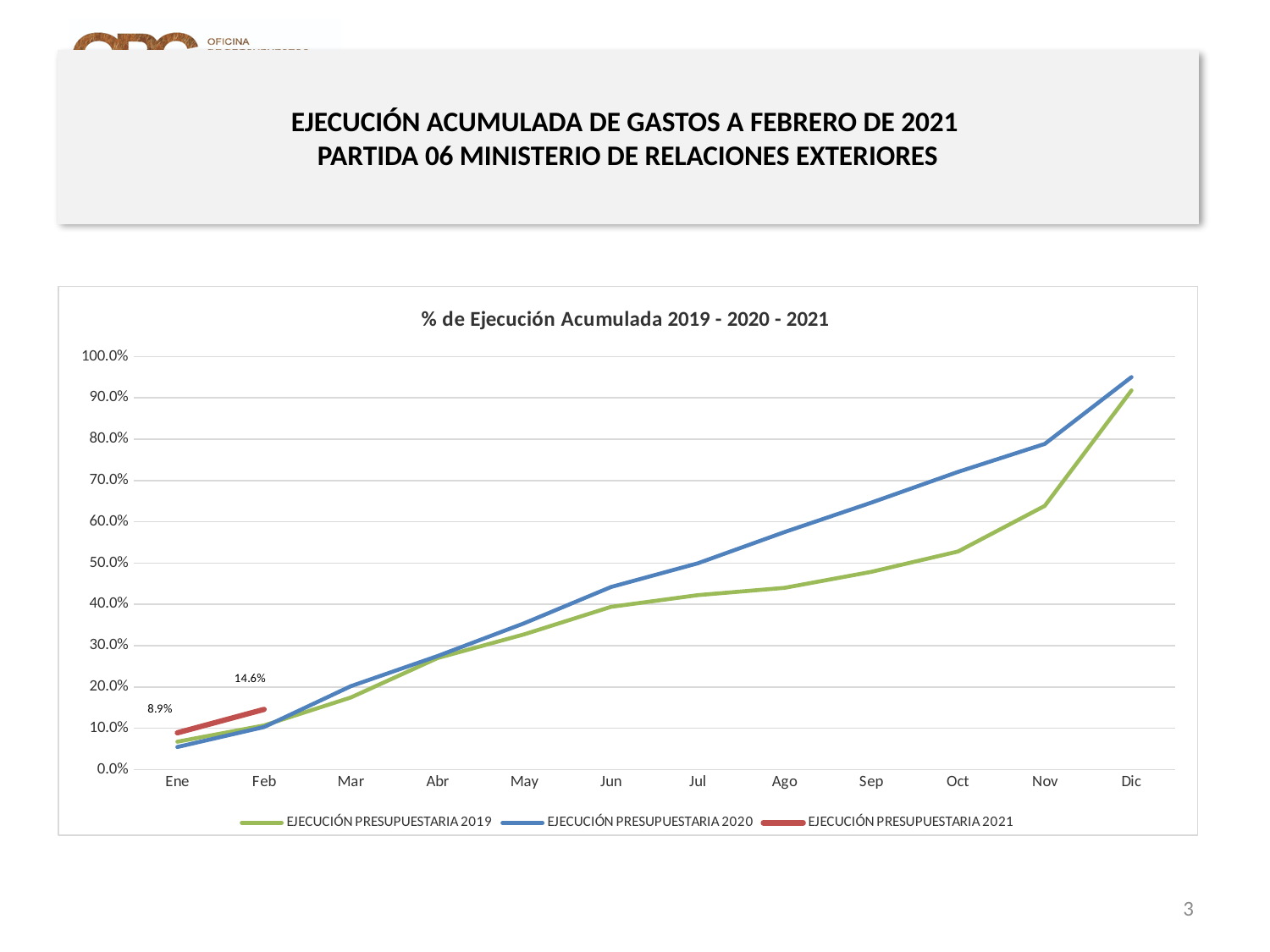
What is the value for EJECUCIÓN PRESUPUESTARIA 2021 in Feb? 14.6% What is the value for EJECUCIÓN PRESUPUESTARIA 2021 in Ene? 8.9% How many months are shown on the x axis? 12 Is the value for EJECUCIÓN PRESUPUESTARIA 2020 in Dic greater or less than 90.0%? greater What is the title of the chart? % de Ejecución Acumulada 2019 - 2020 - 2021 Does the EJECUCIÓN PRESUPUESTARIA 2020 line rise or fall from Ene to Dic? Rise In which month does EJECUCIÓN PRESUPUESTARIA 2020 reach its highest value? Dic What kind of chart is shown on the slide? Line chart What is the difference between the Feb and Ene values for EJECUCIÓN PRESUPUESTARIA 2021? 5.7% How many series does the legend list? 3 In Nov, which series has the higher value, EJECUCIÓN PRESUPUESTARIA 2019 or EJECUCIÓN PRESUPUESTARIA 2020? EJECUCIÓN PRESUPUESTARIA 2020 Is the value for EJECUCIÓN PRESUPUESTARIA 2019 in Oct greater or less than 60.0%? less